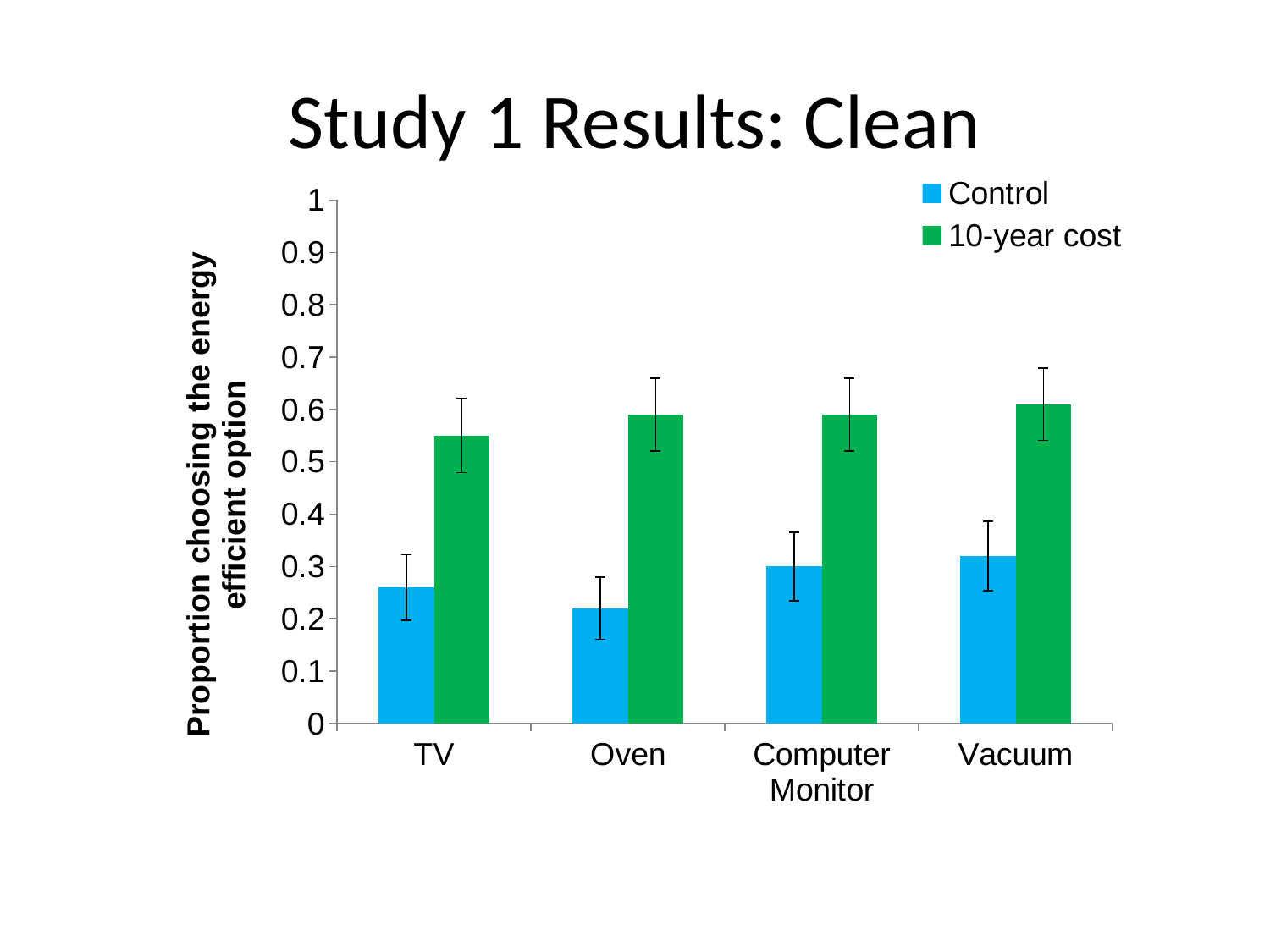
Which series is shown in green? 10-year cost Is the Control value for TV greater or less than 0.3? less For Computer Monitor, which is larger: the Control value or the 10-year cost value? 10-year cost Is the Control value for Vacuum greater or less than 0.2? greater Which category has the lowest Control value? Oven What is the label of the vertical axis? Proportion choosing the energy efficient option How many series does the legend list? 2 Which category has the lowest 10-year cost value? TV What kind of chart is shown on the slide? bar chart Is the 10-year cost value for TV greater or less than 0.7? less How many product categories are shown on the x axis? 4